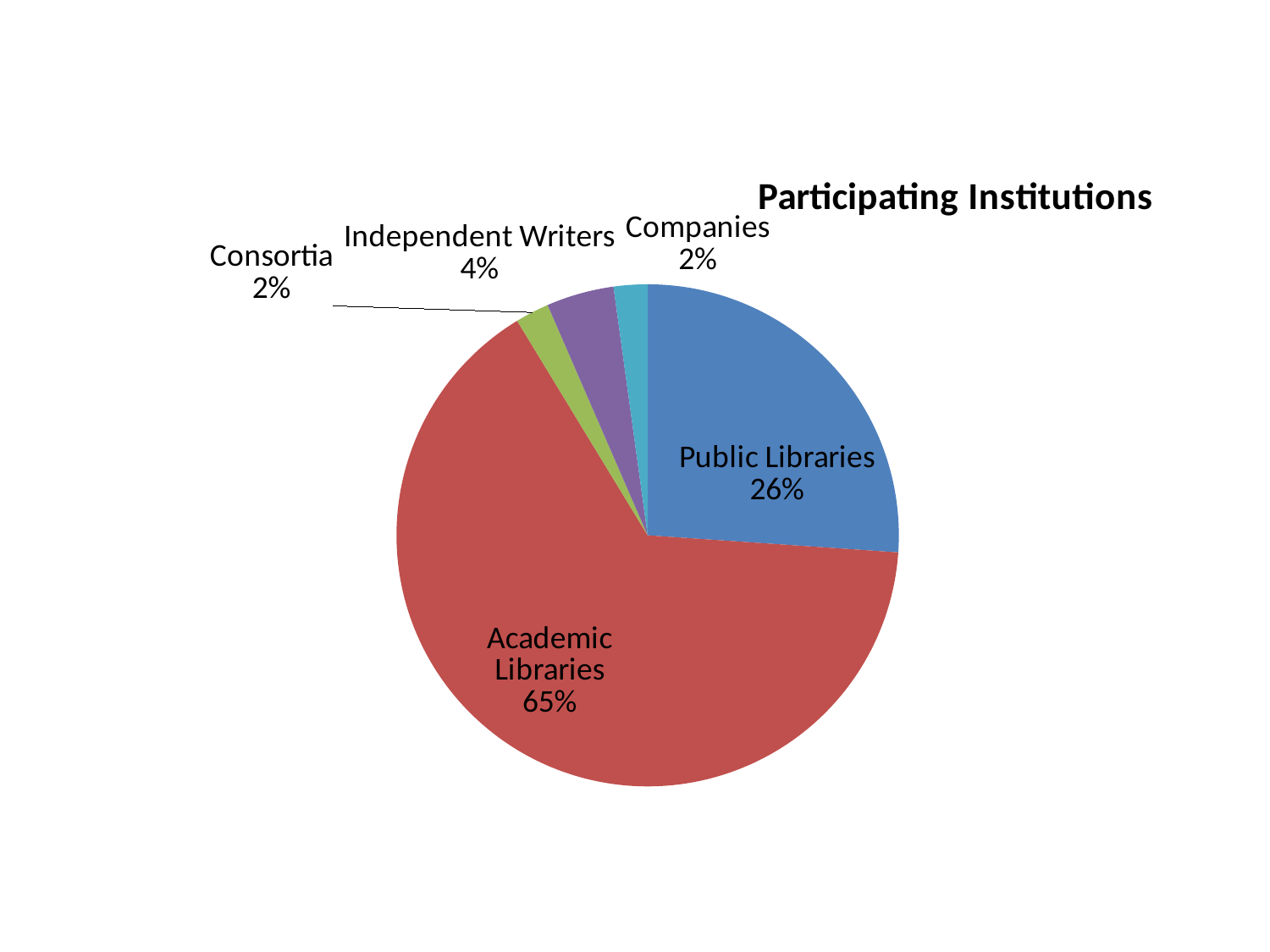
What percentage is shown for Consortia? 2% Which category has the largest slice of the pie? Academic Libraries What percentage is shown for Independent Writers? 4% What is the title of the chart? Participating Institutions What is the difference in percentage points between Academic Libraries and Public Libraries? 39 Which is larger, Public Libraries or Independent Writers? Public Libraries What percentage is shown for Companies? 2% What colour is the Academic Libraries slice? Red How many categories are shown in the pie chart? 5 What share of the pie does Academic Libraries hold? 65% What is the value shown for Public Libraries? 26% What kind of chart is shown on the slide? Pie chart